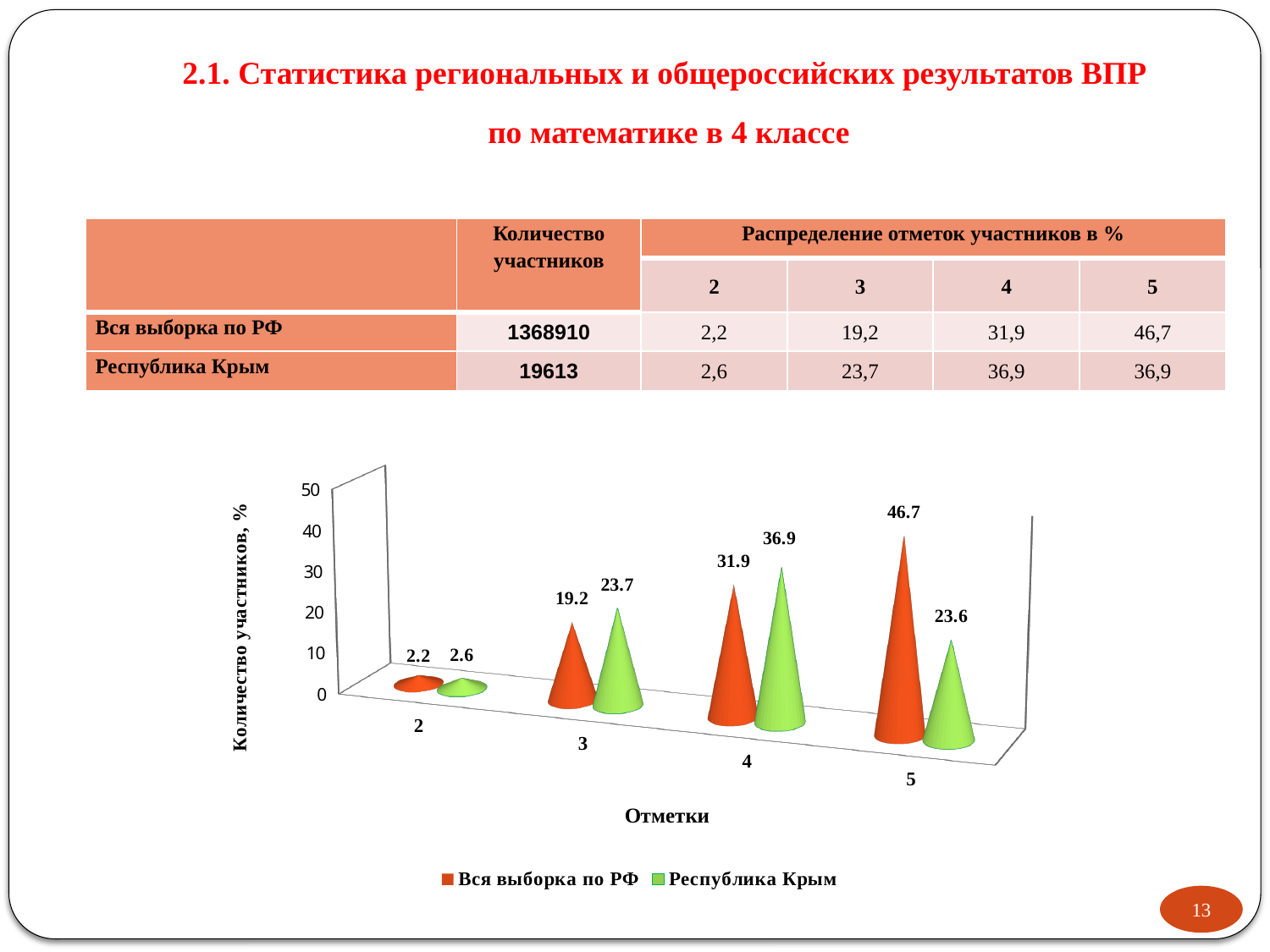
How many series does the chart legend list? 2 How many marks (categories) are shown on the x axis of the chart? 4 What is the value for Республика Крым at mark 5 in the chart? 23.6 Which mark has the lowest value for Республика Крым in the chart? 2 What is the difference between Республика Крым and Вся выборка по РФ at mark 4 in the chart? 5.0 What is the value for Вся выборка по РФ at mark 5 in the chart? 46.7 At mark 5, which series has the larger value in the chart: Вся выборка по РФ or Республика Крым? Вся выборка по РФ What is the value for Вся выборка по РФ at mark 2 in the chart? 2.2 What is the value for Республика Крым at mark 3 in the chart? 23.7 What type of chart is shown on the slide? bar chart What is the label of the vertical axis of the chart? Количество участников, % Which mark has the highest value for Вся выборка по РФ in the chart? 5